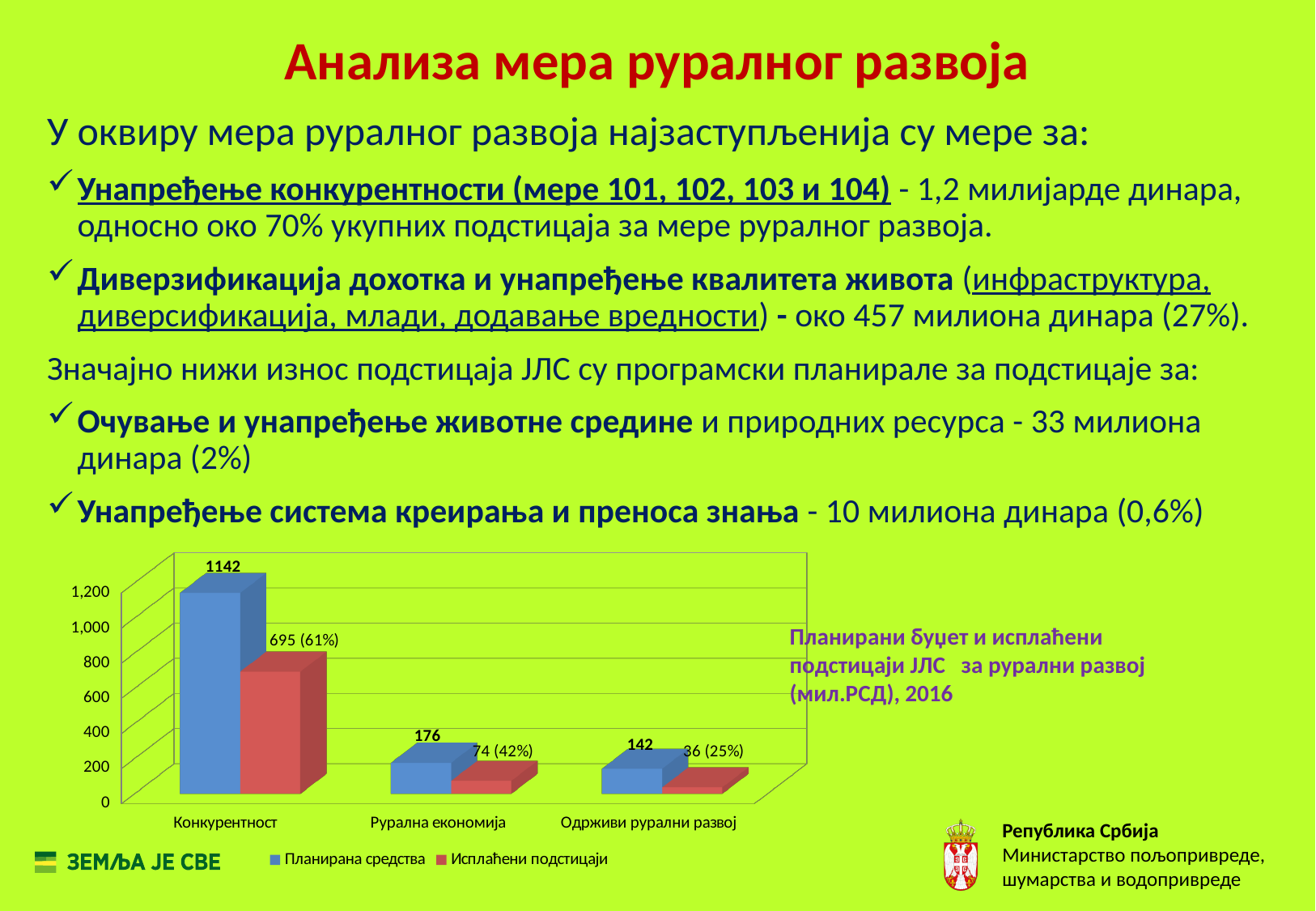
Which category has the highest planned amount (Планирана средства)? Конкурентност What is the paid amount (Исплаћени подстицаји) for Рурална економија? 74 (42%) Which series is shown in blue in the chart? Планирана средства Which is larger: the planned amount for Рурална економија or the planned amount for Одрживи рурални развој? Рурална економија What is the planned amount (Планирана средства) for Конкурентност? 1142 What is the paid amount (Исплаћени подстицаји) for Одрживи рурални развој? 36 (25%) What is the planned amount (Планирана средства) for Одрживи рурални развој? 142 Which category has the lowest paid amount (Исплаћени подстицаји)? Одрживи рурални развој What kind of chart is shown on the slide? Bar chart What is the difference between the planned amount and the paid amount for Конкурентност? 447 How many series does the chart legend list? 2 How many categories are shown on the x axis of the chart? 3